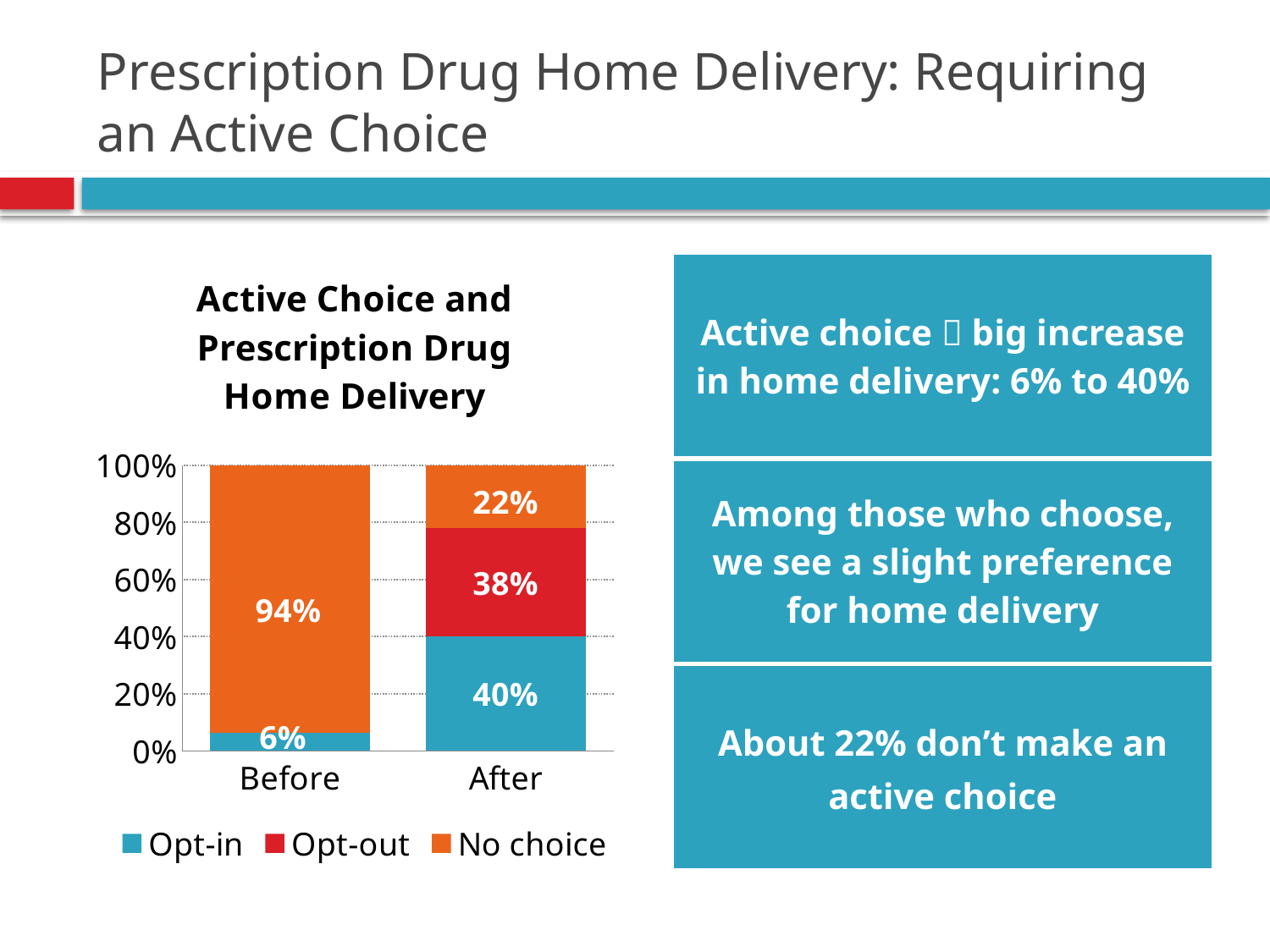
What is the difference between the No choice values for Before and After? 72% How many categories are shown on the x axis? 2 What kind of chart is shown? Stacked bar chart What is the difference between the Opt-in values for After and Before? 34% What is the Opt-out value for After? 38% What is the title of the chart? Active Choice and Prescription Drug Home Delivery What is the Opt-in value for Before? 6% What is the No choice value for After? 22% How many series does the legend list? 3 What is the Opt-in value for After? 40% What is the No choice value for Before? 94% Which category has the higher Opt-in value, Before or After? After